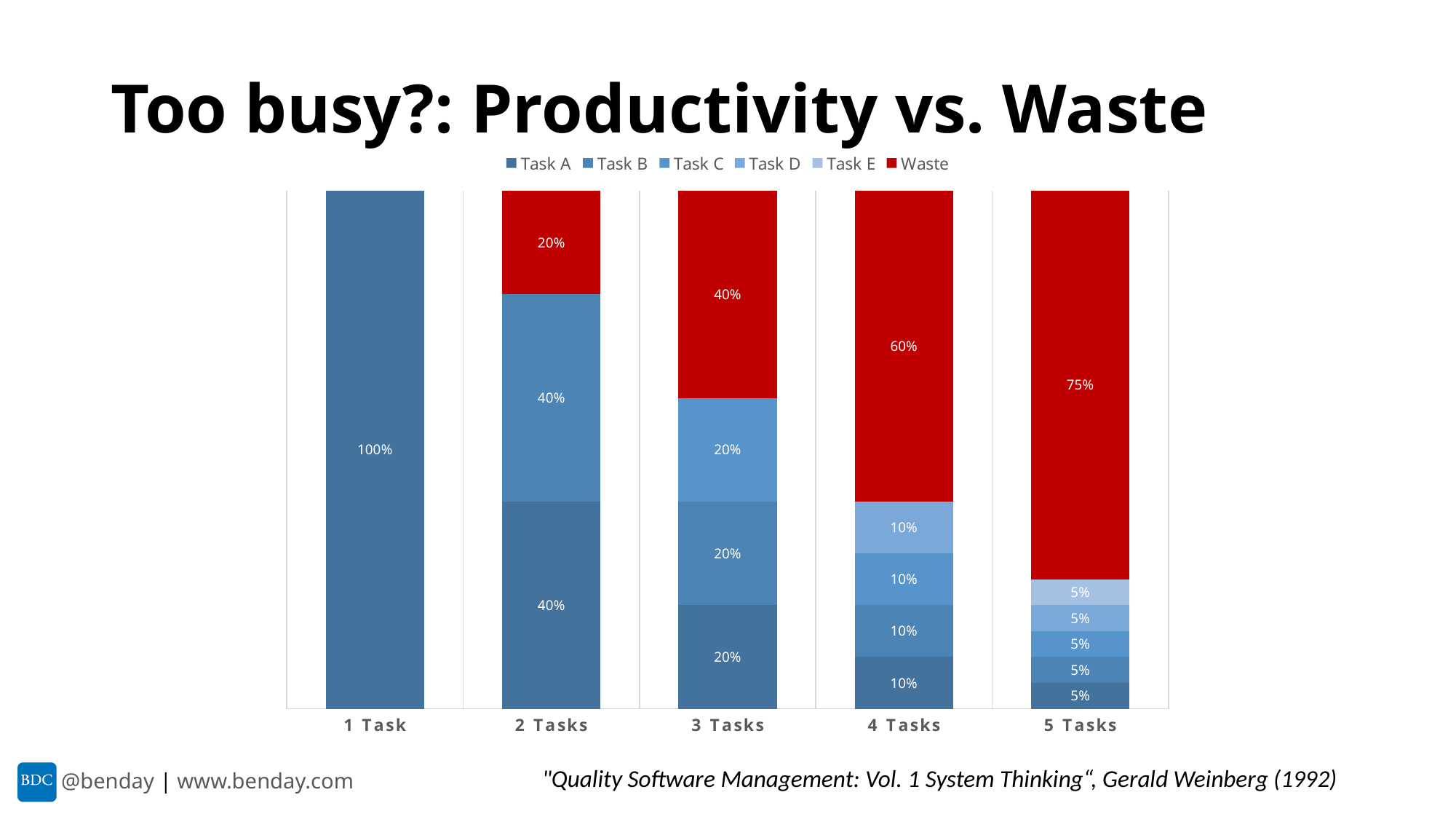
What is the Task D value for 4 Tasks? 10% What is the Task B value for 3 Tasks? 20% What is the Task A value for 1 Task? 100% Does the Waste value rise or fall as the number of tasks increases from 2 Tasks to 5 Tasks? rise What is the difference between the Waste value for 4 Tasks and the Waste value for 2 Tasks? 40% What kind of chart is shown on the slide? stacked bar chart Which category has the highest Waste value? 5 Tasks How many categories are shown on the x axis? 5 What is the Waste value for 5 Tasks? 75% What is the Waste value for 2 Tasks? 20% How many series does the legend list? 6 Is the Waste value for 3 Tasks larger or smaller than the Waste value for 5 Tasks? smaller